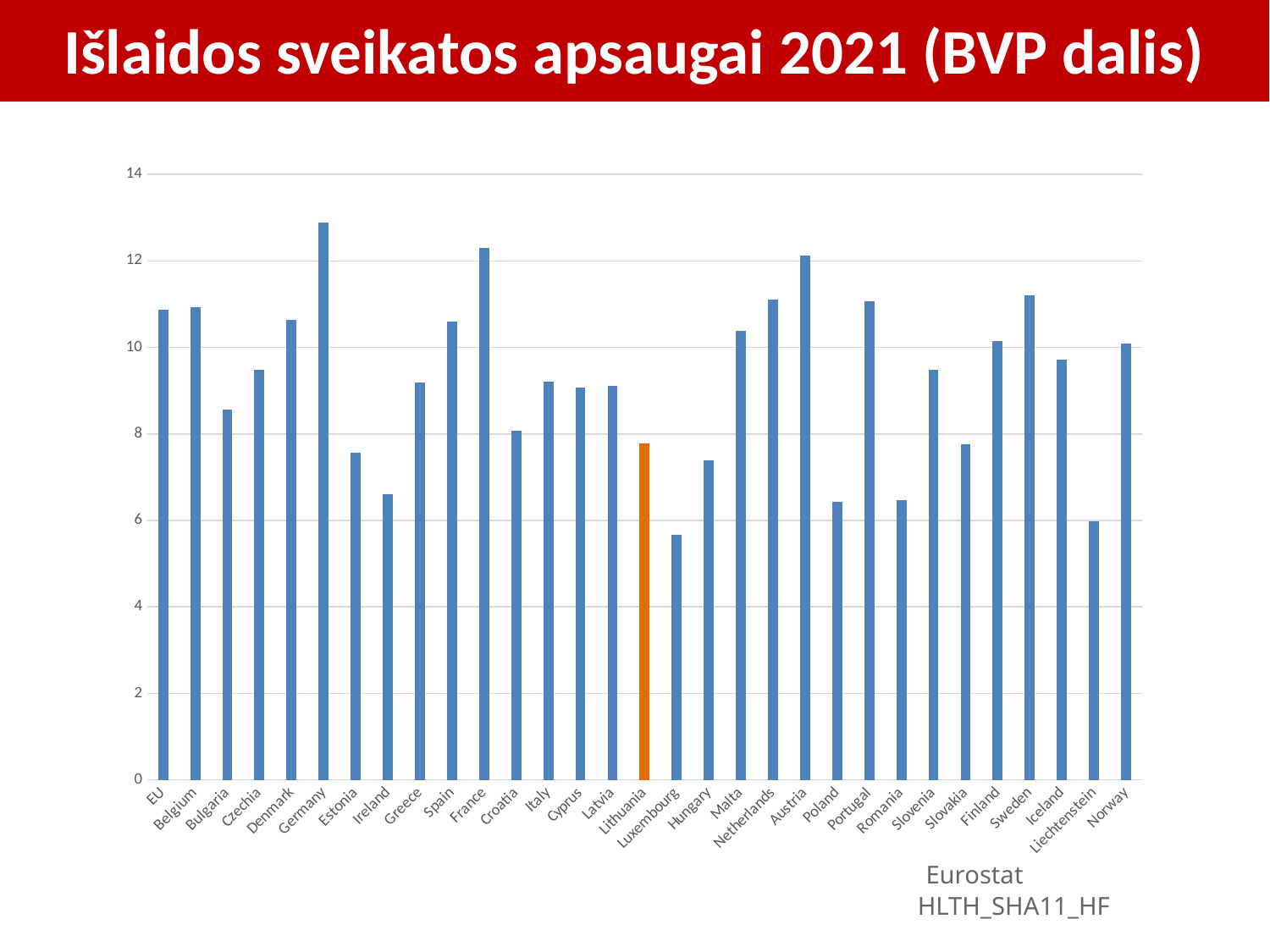
Which country has the highest value on the chart? Germany Is the value for Poland greater or less than 8? less Is the value for Germany greater or less than 12? greater How many categories (bars) are plotted on the chart? 31 What kind of chart is shown on the slide? bar chart Is the value for Lithuania greater or less than 10? less Which is larger, the value for Germany or the value for France? Germany Which country has the lowest value on the chart? Luxembourg Which country's bar is highlighted in orange? Lithuania Which is larger, the value for Latvia or the value for Lithuania? Latvia